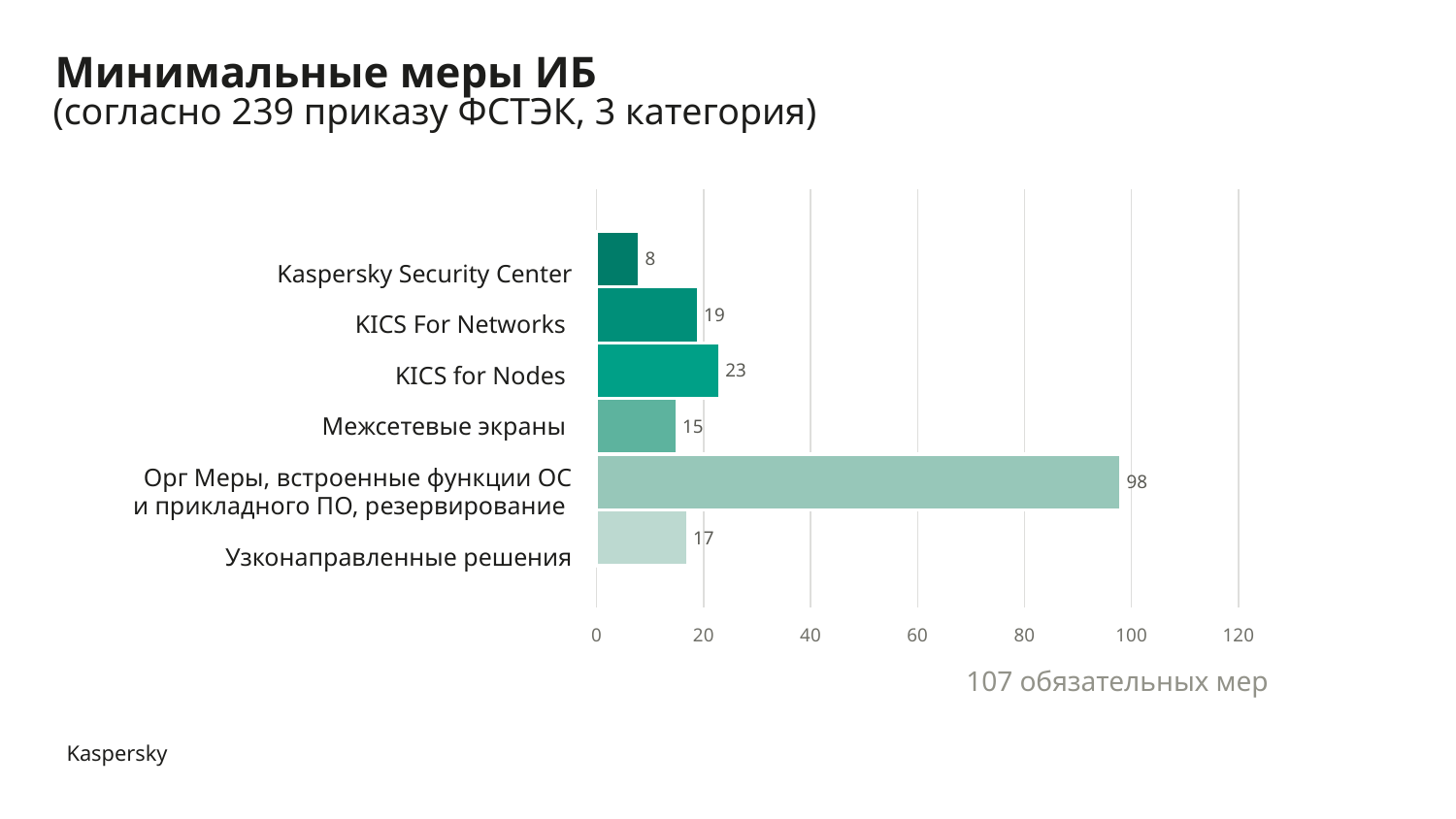
What is the value for Межсетевые экраны? 15 Which is larger, the value for Узконаправленные решения or the value for Межсетевые экраны? Узконаправленные решения What is the difference between the values for KICS for Nodes and KICS For Networks? 4 What is the value for Узконаправленные решения? 17 How many categories are shown in the chart? 6 What is the text shown below the x axis of the chart? 107 обязательных мер What is the value for KICS For Networks? 19 What kind of chart is shown on the slide? Bar chart What is the value for Kaspersky Security Center? 8 Which category has the lowest value? Kaspersky Security Center What is the value for KICS for Nodes? 23 Which category has the highest value? Орг Меры, встроенные функции ОС и прикладного ПО, резервирование